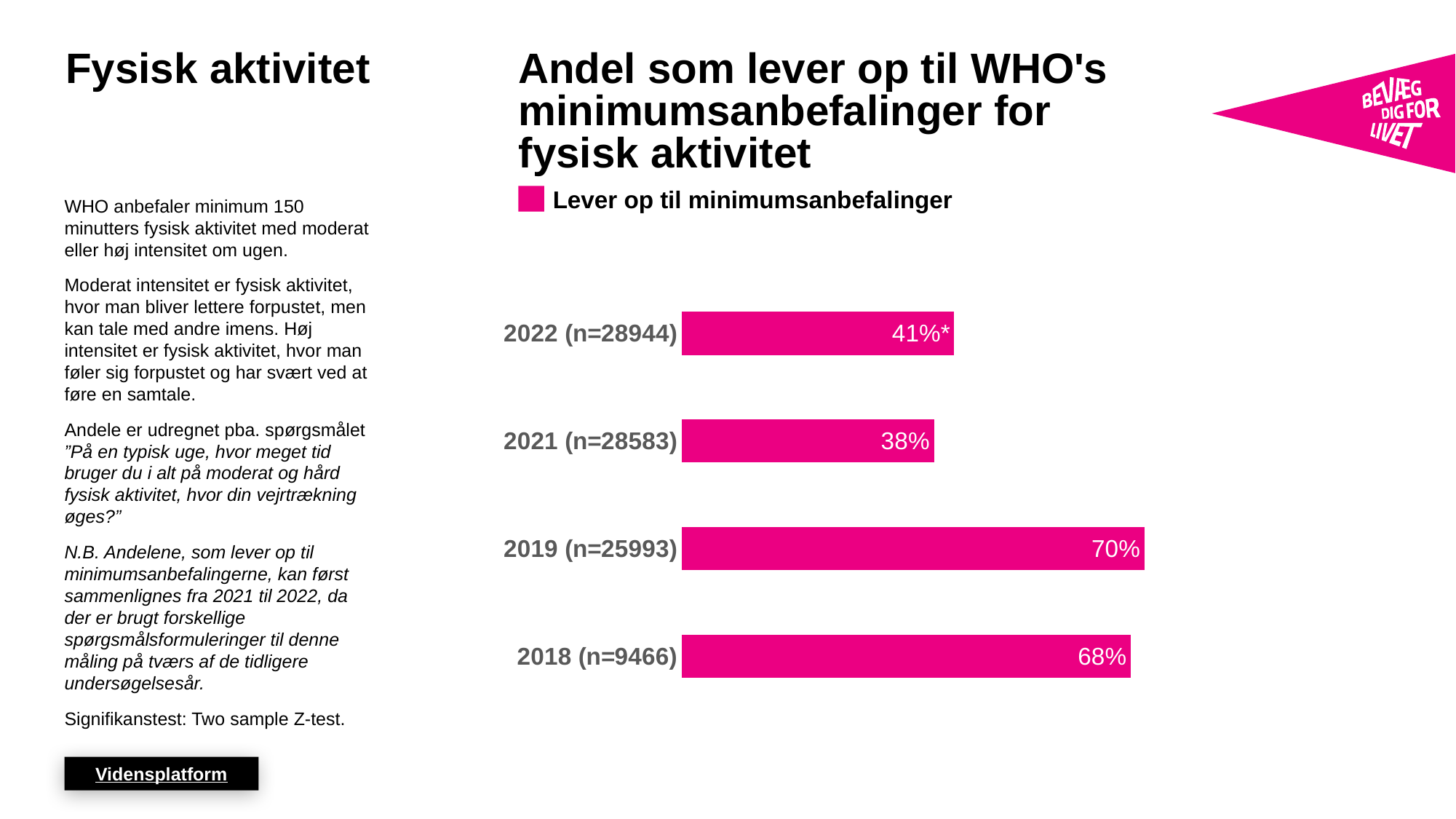
What is the value for 2021 (n=28583)? 38% What is the value for 2019 (n=25993)? 70% Which year has the highest share meeting the minimum recommendations? 2019 (n=25993) Which year has the lowest share meeting the minimum recommendations? 2021 (n=28583) What kind of chart is shown on the slide? Bar chart What is the difference between the values for 2022 and 2021? 3 percentage points What is the legend entry shown for the chart? Lever op til minimumsanbefalinger What is the value for 2022 (n=28944)? 41%* How many years (bars) are shown in the chart? 4 What is the value for 2018 (n=9466)? 68% What is the difference between the values for 2019 and 2018? 2 percentage points Which is larger, the value for 2022 or the value for 2021? 2022